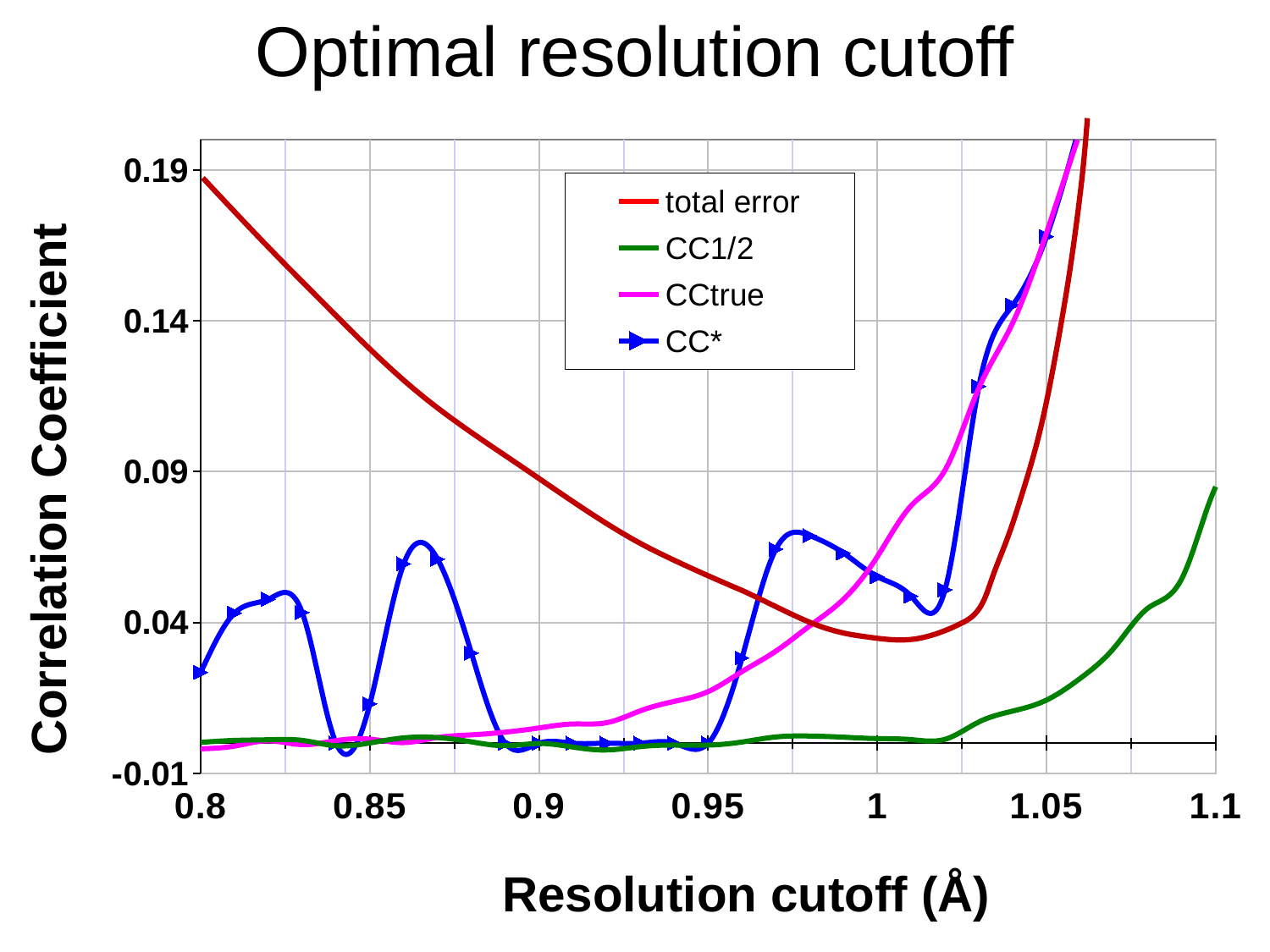
How many series does the legend list? 4 Is the value of the CC1/2 series at a resolution cutoff of 0.9 greater or less than 0.04? less Is the value of the CC* series at a resolution cutoff of 0.85 greater or less than 0.04? less What kind of chart is shown on the slide? line chart What is the label of the x axis? Resolution cutoff (Å) At a resolution cutoff of 0.9, which series has the larger value, total error or CC1/2? total error Which series has the highest value at a resolution cutoff of 0.8? total error Is the value of the total error series at a resolution cutoff of 0.8 greater or less than 0.14? greater Does the total error series rise or fall as the resolution cutoff increases from 0.8 to 1.0? fall At a resolution cutoff of 1.05, which series has the larger value, total error or CCtrue? CCtrue What is the title of the chart? Optimal resolution cutoff